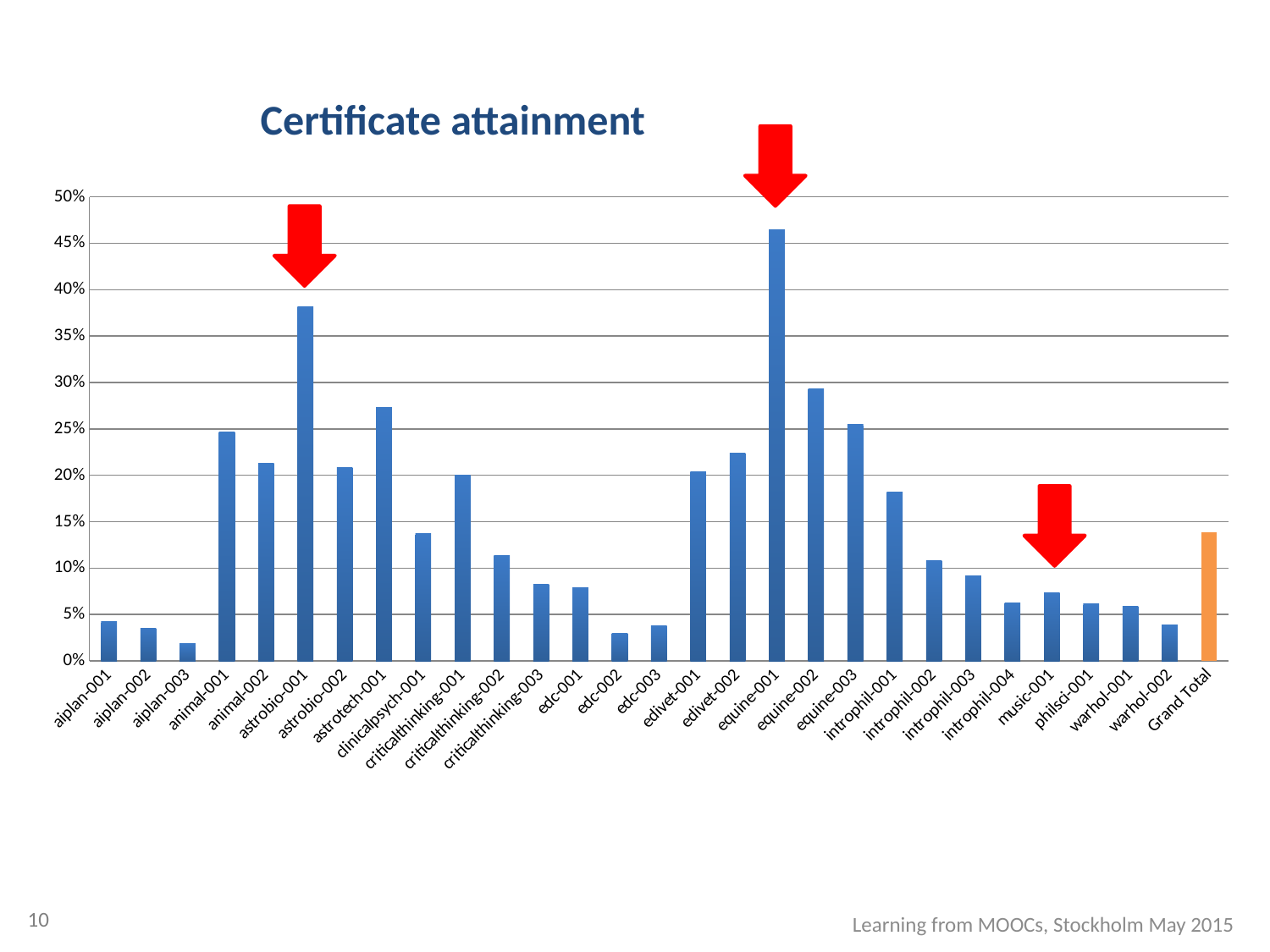
Which has a higher certificate attainment, equine-002 or equine-003? equine-002 Is the value for equine-001 greater or less than 45%? greater Is the value for astrobio-001 greater or less than 35%? greater Is the value for Grand Total greater or less than 15%? less Which bar is shown in a different colour (orange) from the rest? Grand Total How many bars (categories) are plotted in the chart, including Grand Total? 29 Which category has the lowest certificate attainment? aiplan-003 What kind of chart is shown on the slide? bar chart What is the title of the chart? Certificate attainment Which category has the highest certificate attainment? equine-001 Which has a higher certificate attainment, animal-001 or animal-002? animal-001